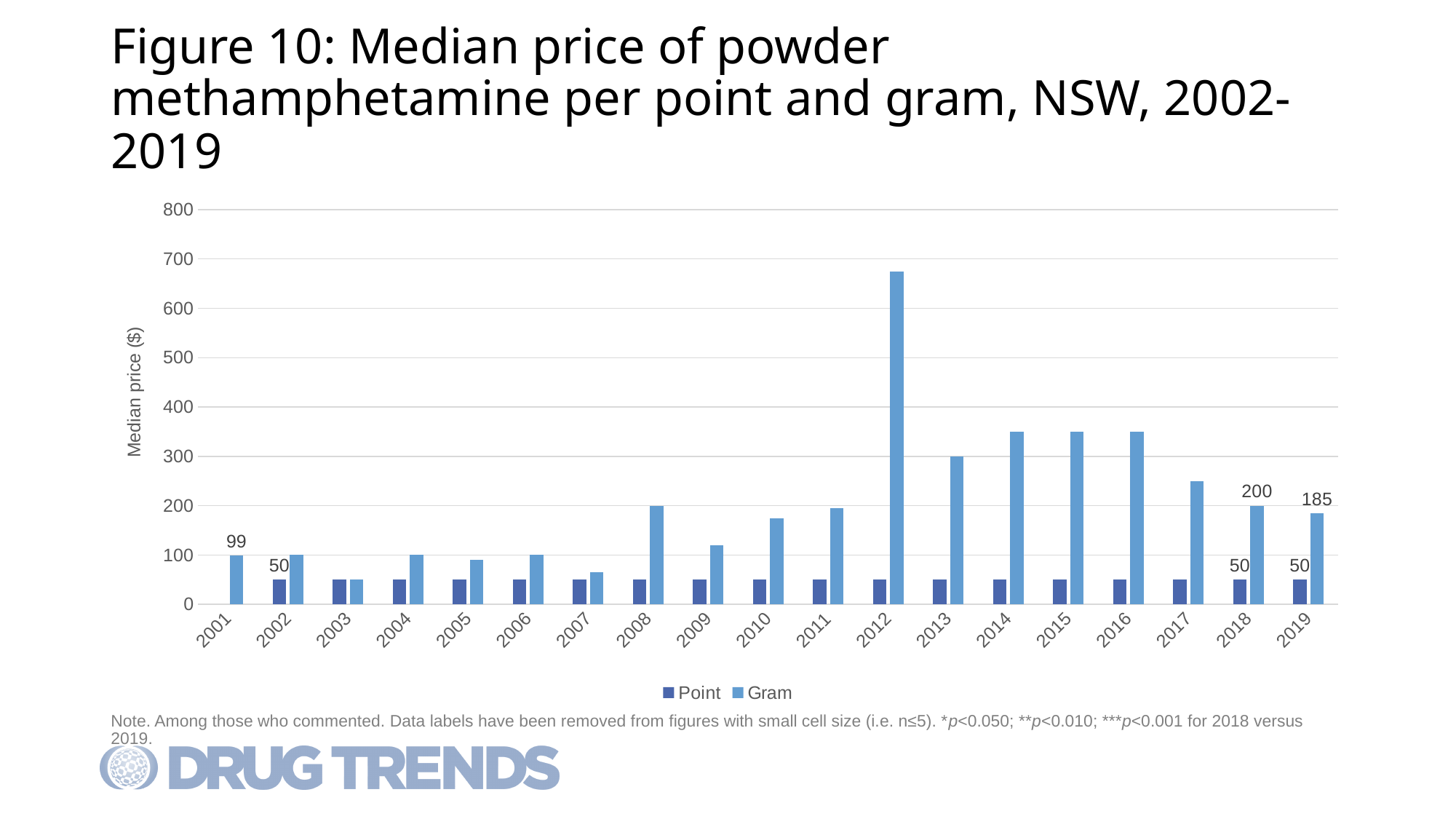
What is the median price per point in 2019? 50 By how much did the median price per gram fall from 2018 to 2019? 15 Is the median price per gram in 2017 greater or less than 200? greater Is the median price per gram in 2012 greater or less than 600? greater In which year is the median price per gram highest? 2012 What is the median price per gram in 2001? 99 How many years are shown on the x axis? 19 How many series does the legend list? 2 What is the median price per gram in 2019? 185 What is the difference between the Gram and Point median prices in 2019? 135 What is the median price per gram in 2018? 200 Which year has the higher median price per gram, 2018 or 2019? 2018